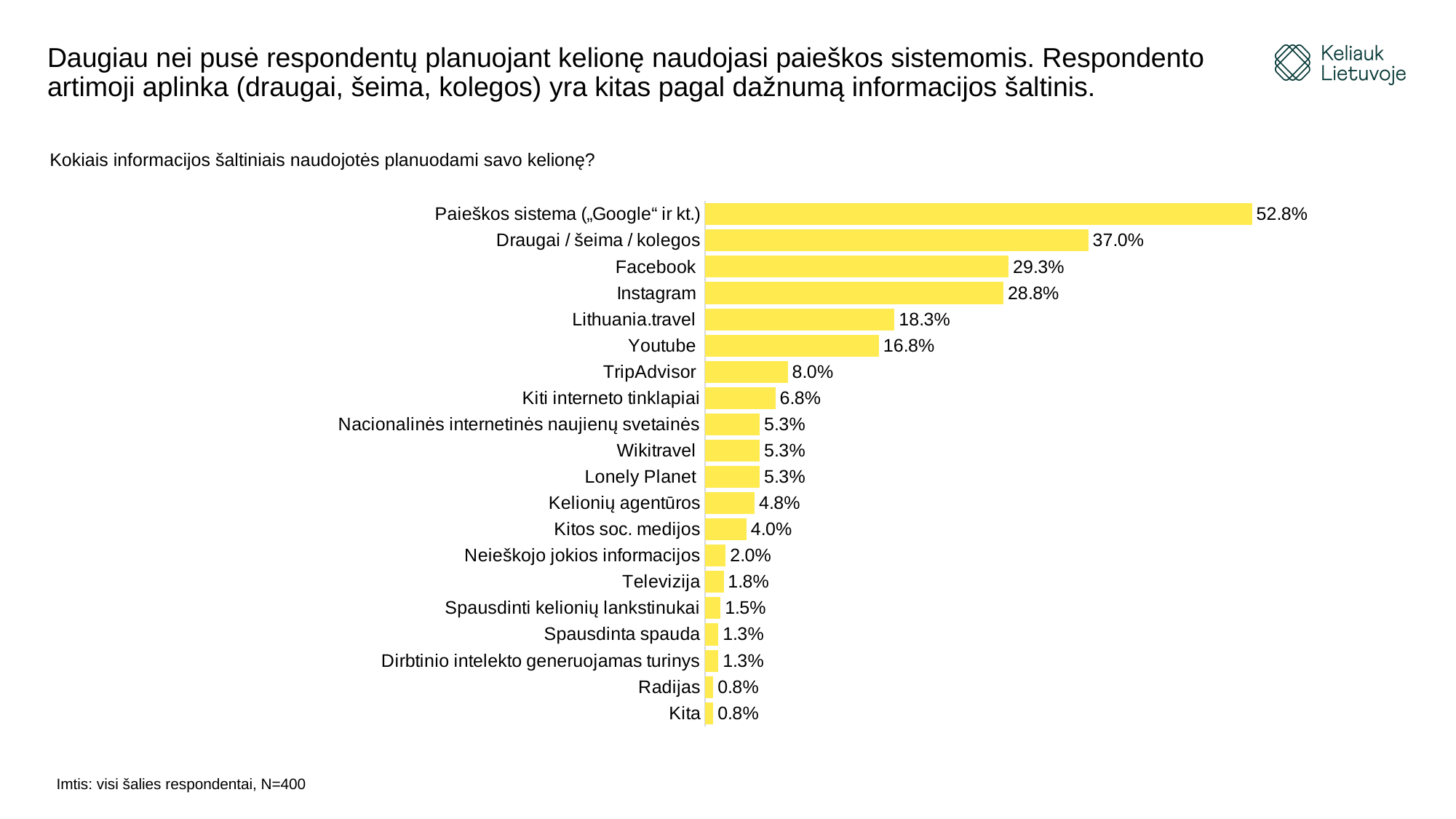
What is the value shown for Dirbtinio intelekto generuojamas turinys? 1.3% Which has a larger value, Facebook or Instagram? Facebook What is the value shown for Lithuania.travel? 18.3% What colour are the bars in the chart? Yellow What is the value shown for TripAdvisor? 8.0% What type of chart is shown on the slide? Bar chart What is the difference between the values for Youtube and TripAdvisor? 8.8% What is the difference between the values for Draugai / šeima / kolegos and Facebook? 7.7% How many information sources (categories) are shown in the chart? 20 Which has a larger value, Kelionių agentūros or Kitos soc. medijos? Kelionių agentūros What percentage of respondents used Paieškos sistema („Google“ ir kt.) when planning their trip? 52.8% Which information source has the highest value in the chart? Paieškos sistema („Google“ ir kt.)